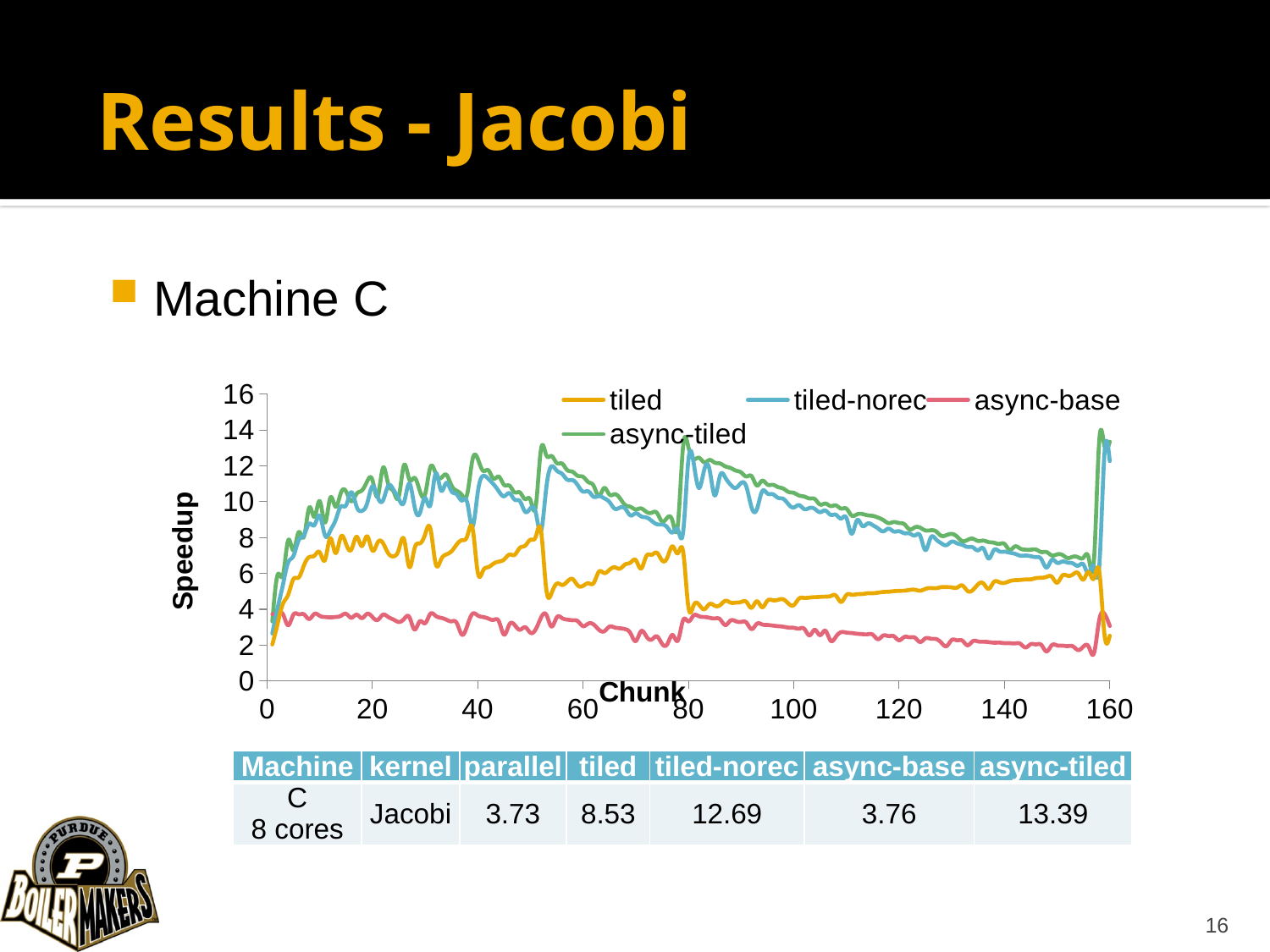
At chunk 140, which series has the higher speedup, tiled or async-base? tiled What is the title of the x axis of the chart? Chunk What is the title of the y axis of the chart? Speedup Is the speedup for async-tiled at chunk 60 greater or less than 8? greater At chunk 100, which series has the higher speedup, async-tiled or async-base? async-tiled What kind of chart is shown on the slide? line chart Does the speedup for async-tiled rise or fall between chunk 80 and chunk 150? fall Is the speedup for async-base at chunk 100 greater or less than 4? less Which series has the lowest speedup across the chart? async-base Is the speedup for tiled-norec at chunk 20 greater or less than 8? greater How many series does the chart legend list? 4